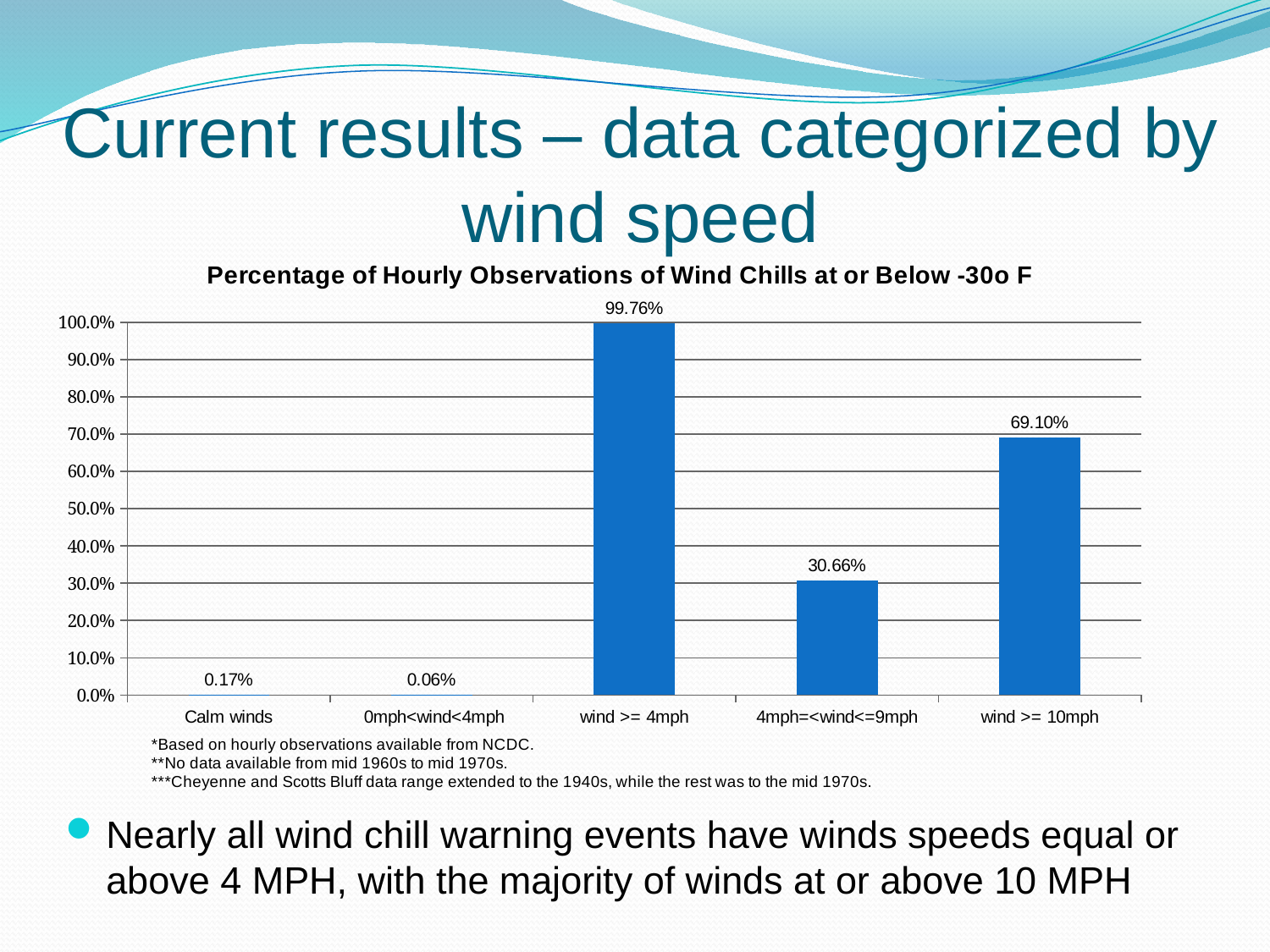
What is the value for wind >= 4mph? 99.76% Which category has the highest value? wind >= 4mph What is the value for wind >= 10mph? 69.10% What is the value for Calm winds? 0.17% What is the difference between the values for wind >= 4mph and wind >= 10mph? 30.66% What is the title of the chart? Percentage of Hourly Observations of Wind Chills at or Below -30o F How many categories are shown on the x axis? 5 What is the value for 4mph=<wind<=9mph? 30.66% What kind of chart is shown on the slide? bar chart Which is larger, the value for wind >= 10mph or the value for 4mph=<wind<=9mph? wind >= 10mph Which category has the lowest value? 0mph<wind<4mph What is the value for 0mph<wind<4mph? 0.06%